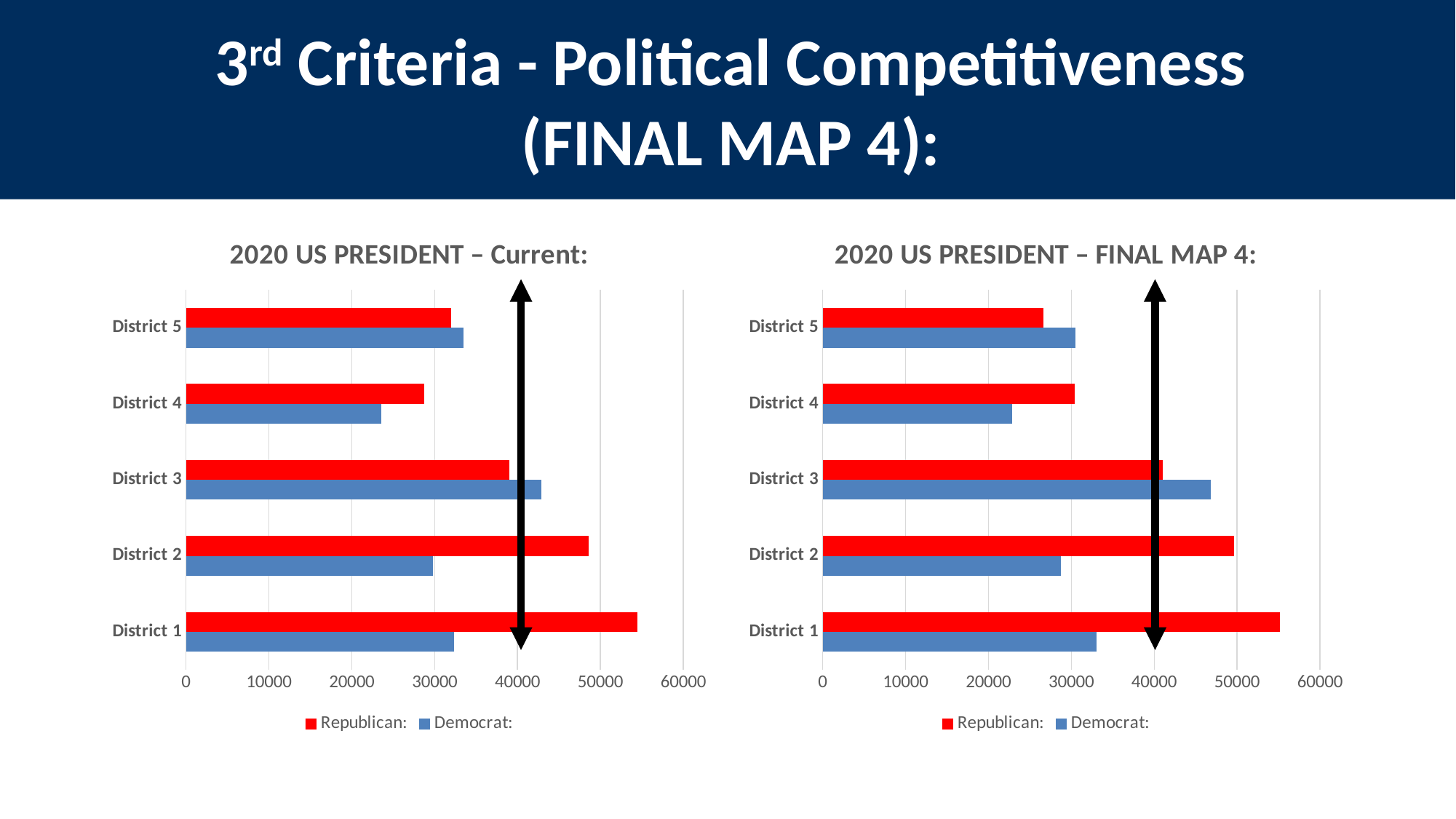
What kind of chart is the "2020 US PRESIDENT – Current:" chart? bar chart In the "2020 US PRESIDENT – Current:" chart, is the Democrat value for District 4 greater or less than 30000? less In the "2020 US PRESIDENT – FINAL MAP 4:" chart, is the Republican value for District 5 greater or less than 30000? less In the "2020 US PRESIDENT – Current:" chart, is the Republican value for District 1 greater or less than 50000? greater In the "2020 US PRESIDENT – FINAL MAP 4:" chart, which district has the lowest Democrat value? District 4 How many series does the legend of the "2020 US PRESIDENT – Current:" chart list? 2 In the "2020 US PRESIDENT – FINAL MAP 4:" chart, which district has the lowest Republican value? District 5 In the "2020 US PRESIDENT – Current:" chart, which is larger for District 2, the Republican value or the Democrat value? Republican What colour are the Democrat bars in the "2020 US PRESIDENT – FINAL MAP 4:" chart? blue How many districts are shown on the "2020 US PRESIDENT – FINAL MAP 4:" chart? 5 In the "2020 US PRESIDENT – Current:" chart, which district has the highest Republican value? District 1